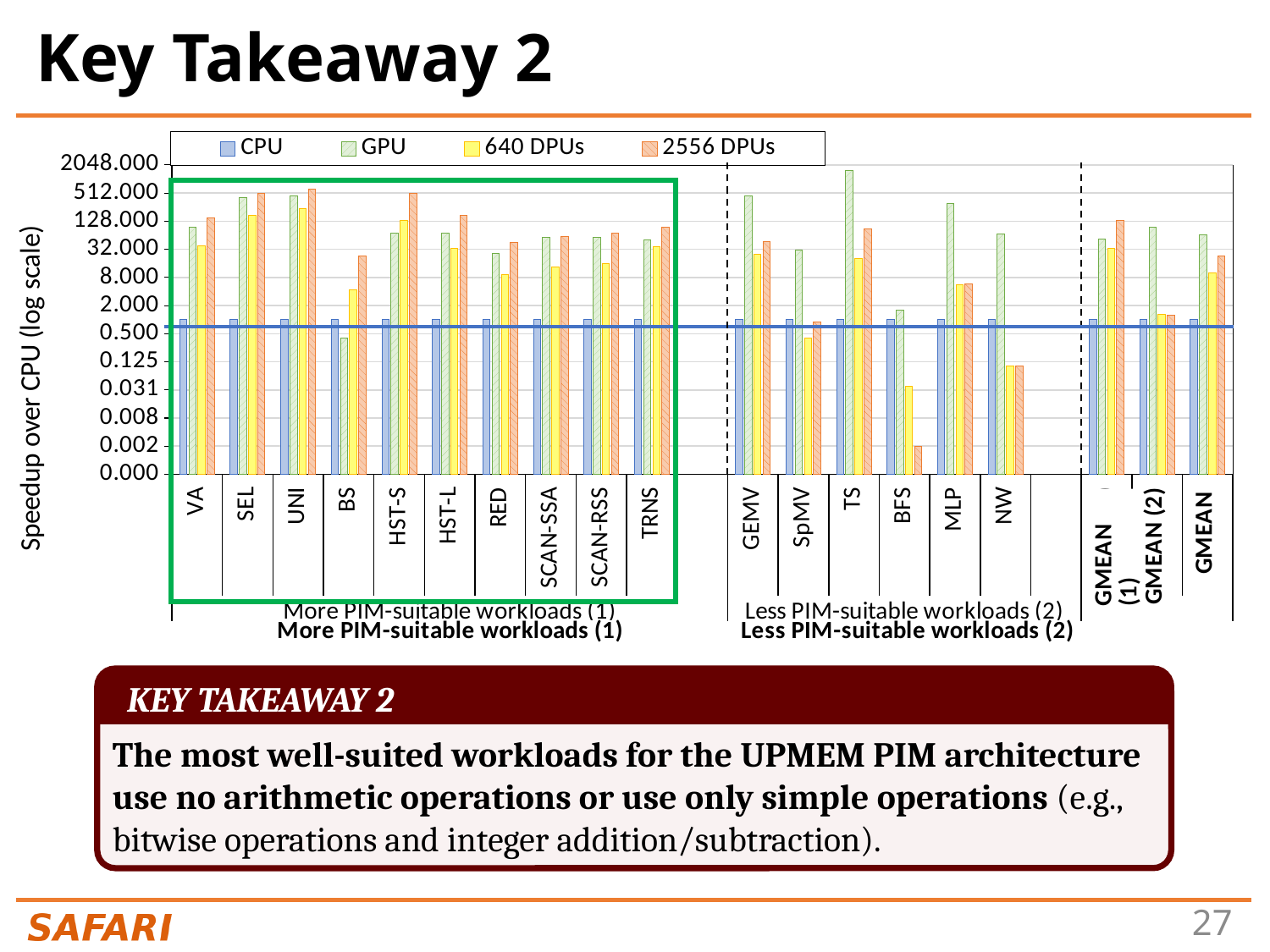
For the BS workload, which is larger: the GPU value or the 2556 DPUs value? 2556 DPUs Is the GPU value for TS greater or less than 512.000? greater Is the GPU value for GEMV greater or less than 128.000? greater Is the 2556 DPUs value for BFS greater or less than 0.008? less How many series does the chart legend list? 4 What kind of chart is shown on the slide? bar chart What is the label of the y axis of the chart? Speedup over CPU (log scale) For the MLP workload, which is larger: the GPU value or the 2556 DPUs value? GPU Which series has the highest bar for the TS workload? GPU Which workload has the tallest GPU bar in the chart? TS